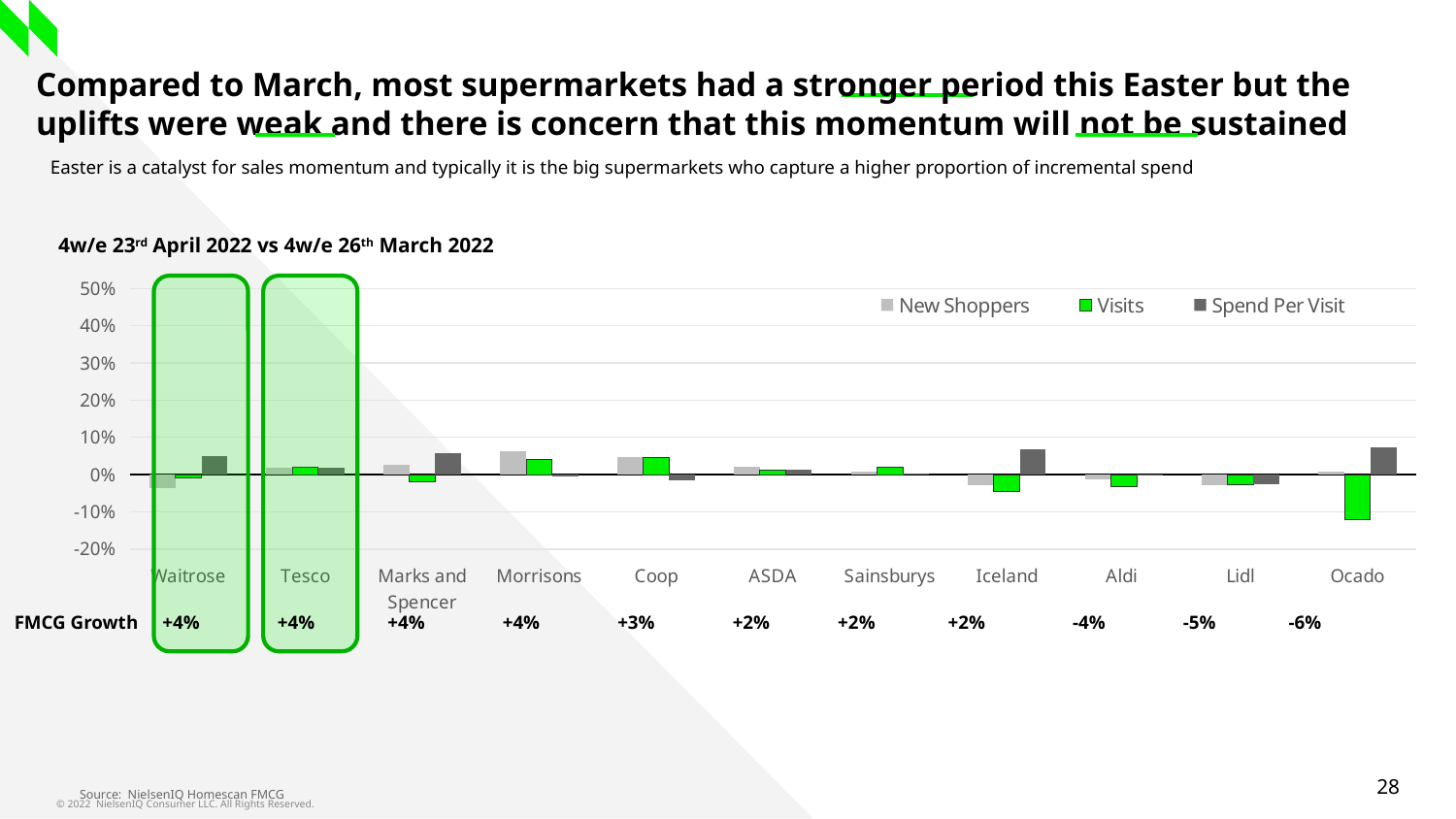
How many supermarkets are shown on the x axis of the chart? 11 Which supermarket has the lowest Visits value? Ocado How many series does the chart legend list? 3 Is the Spend Per Visit value for Iceland greater or less than 0%? greater Which is larger for Waitrose: the Spend Per Visit value or the New Shoppers value? Spend Per Visit Is the New Shoppers value for Waitrose greater or less than 0%? less Is the Visits value for Ocado greater or less than -10%? less What is the title of the chart? 4w/e 23rd April 2022 vs 4w/e 26th March 2022 What are the three series listed in the chart legend? New Shoppers, Visits, Spend Per Visit Which has the larger Visits value: Iceland or Ocado? Iceland What kind of chart is shown on the slide? bar chart What is the highest value shown on the chart's y axis? 50%